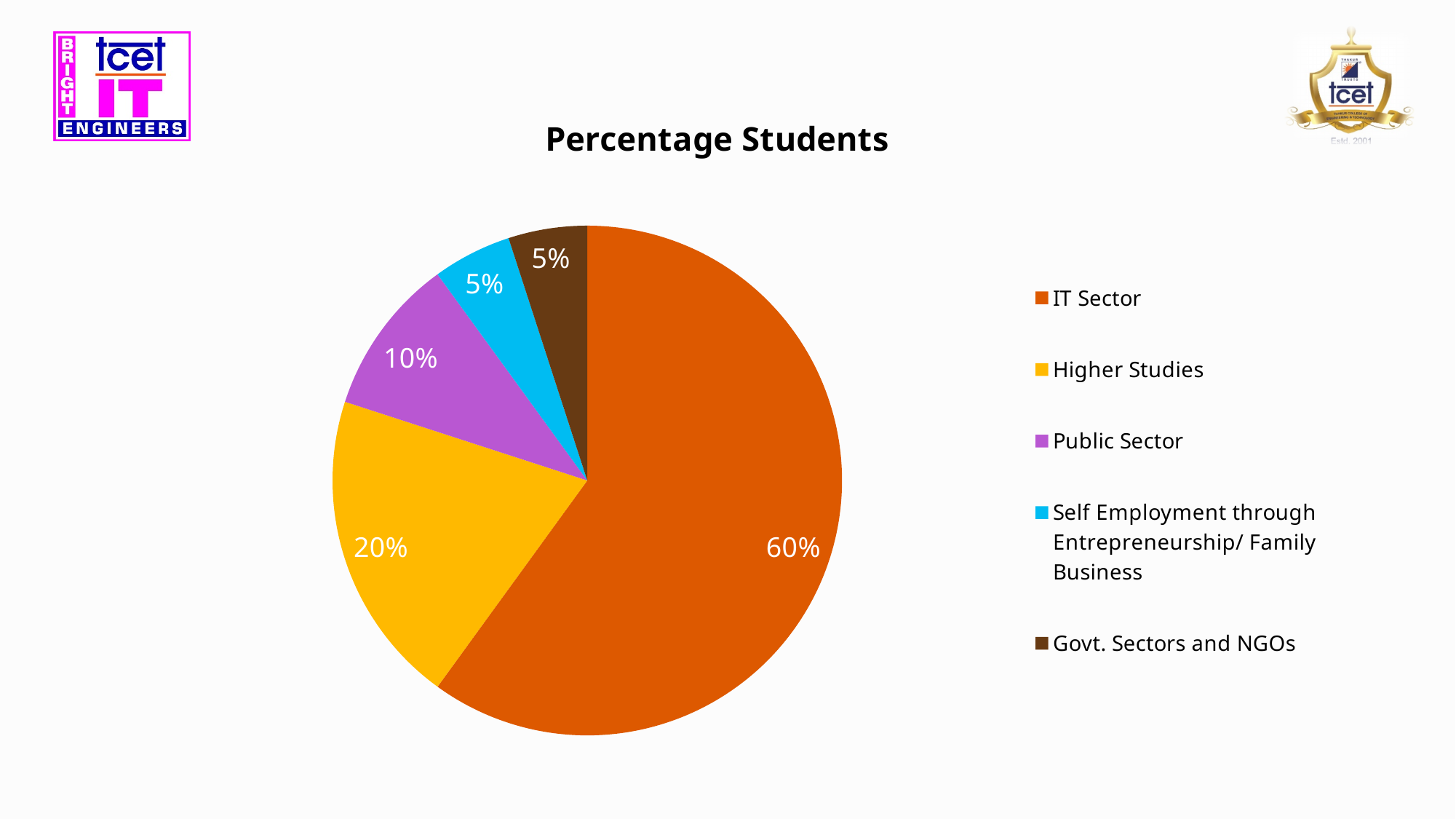
What percentage of students is shown for IT Sector? 60% What is the difference between the IT Sector share and the Higher Studies share? 40% What is the combined share of Public Sector and Higher Studies? 30% What percentage of students is shown for Public Sector? 10% What percentage of students is shown for Govt. Sectors and NGOs? 5% What percentage of students is shown for Higher Studies? 20% What is the title of the chart? Percentage Students What colour is the slice for Self Employment through Entrepreneurship/ Family Business? Blue How many categories does the legend list? 5 Which category has the largest share of the pie? IT Sector What type of chart is shown on the slide? Pie chart Which is larger, the share for Higher Studies or the share for Public Sector? Higher Studies